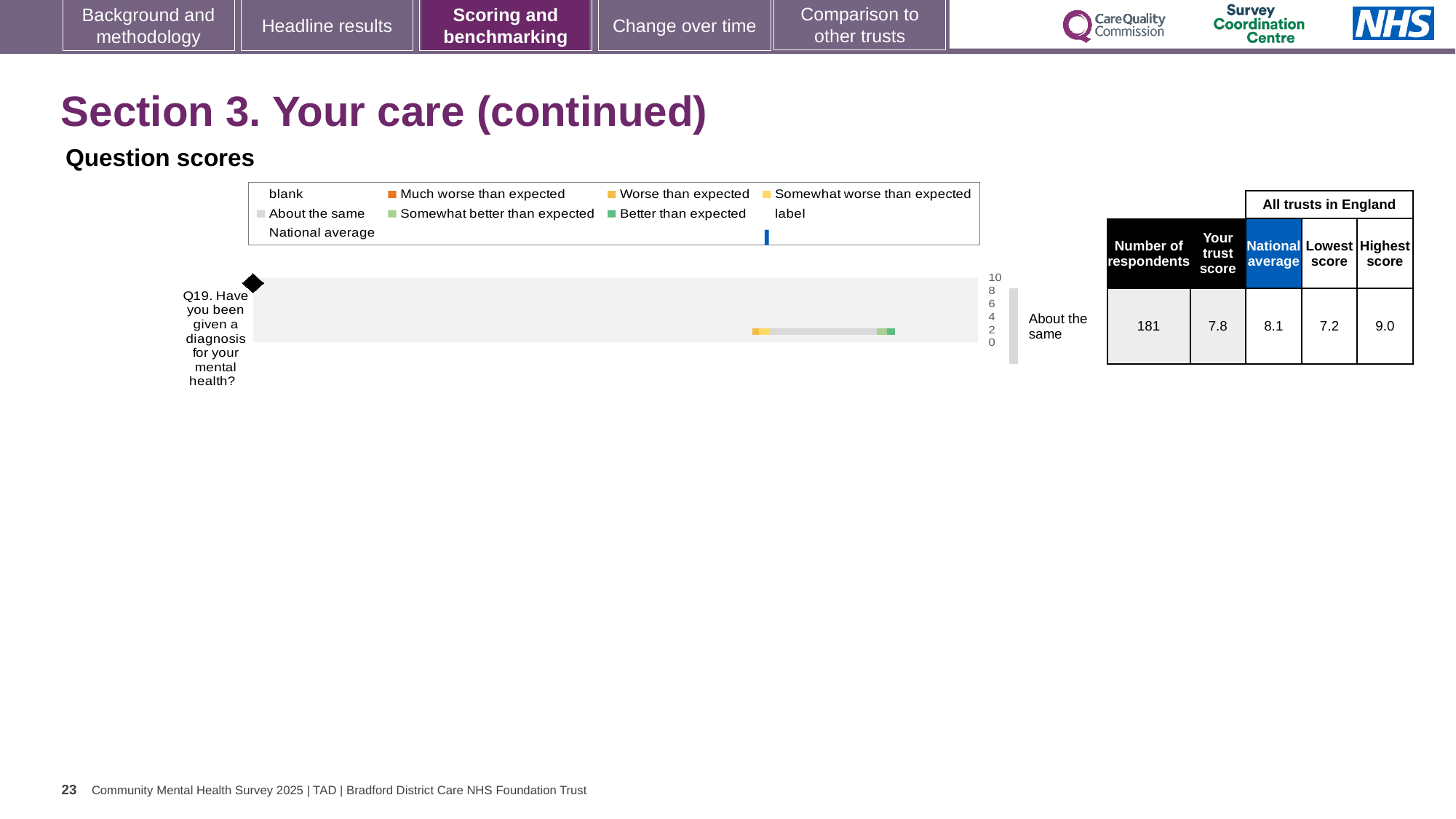
How many questions are plotted in the Question scores chart? 1 What kind of chart is used to show the Q19 question score? bar chart For Q19, how much higher is the national average than the trust score? 0.3 What is the lowest score among all trusts in England for Q19? 7.2 What is the trust score for Q19? 7.8 What is the highest score among all trusts in England for Q19? 9.0 For Q19, what is the difference between the highest score and the lowest score among all trusts in England? 1.8 For Q19, which is larger: the trust score or the national average? National average What is the national average score for Q19? 8.1 Which question is plotted in the Question scores chart? Q19. Have you been given a diagnosis for your mental health? What benchmark category label is shown next to the bar for Q19? About the same What is the number of respondents for Q19? 181